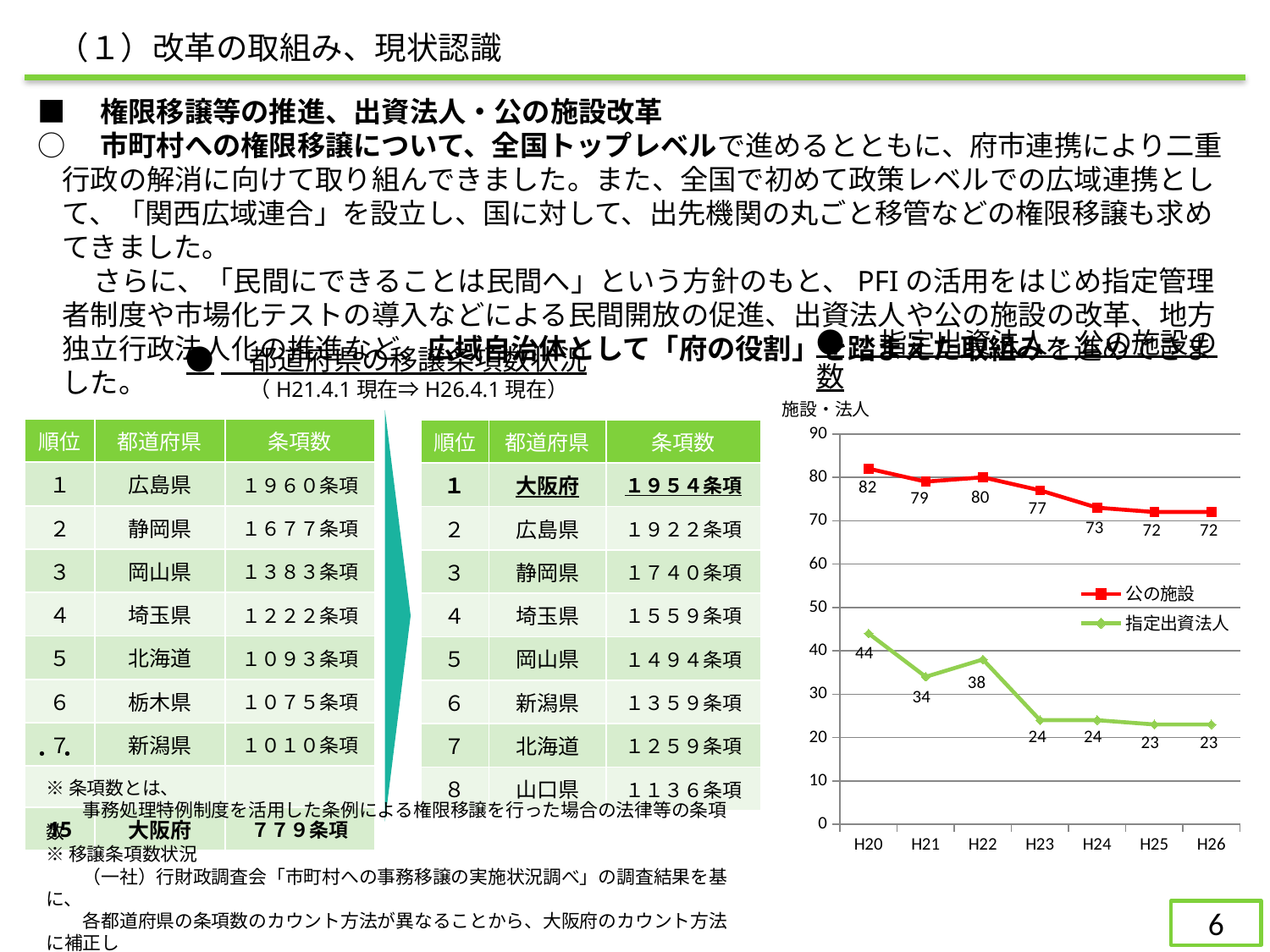
How many years are plotted on the x axis of the line chart? 7 In the line chart, what is the value of 指定出資法人 for H26? 23 In the line chart, which year has the highest value for 指定出資法人? H20 In the line chart, which year has the lowest value for 公の施設? H25 and H26 What type of chart is shown on the right side of the slide? line chart In the line chart, what is the value of 指定出資法人 for H22? 38 In the line chart, what is the difference between 公の施設 and 指定出資法人 in H21? 45 In the line chart, what is the value of 公の施設 for H24? 73 In the line chart, what is the value of 公の施設 for H20? 82 In the line chart, which is larger in H23: 公の施設 or 指定出資法人? 公の施設 How many series does the legend of the line chart list? 2 In the line chart, does the value of 指定出資法人 generally rise or fall from H20 to H26? fall